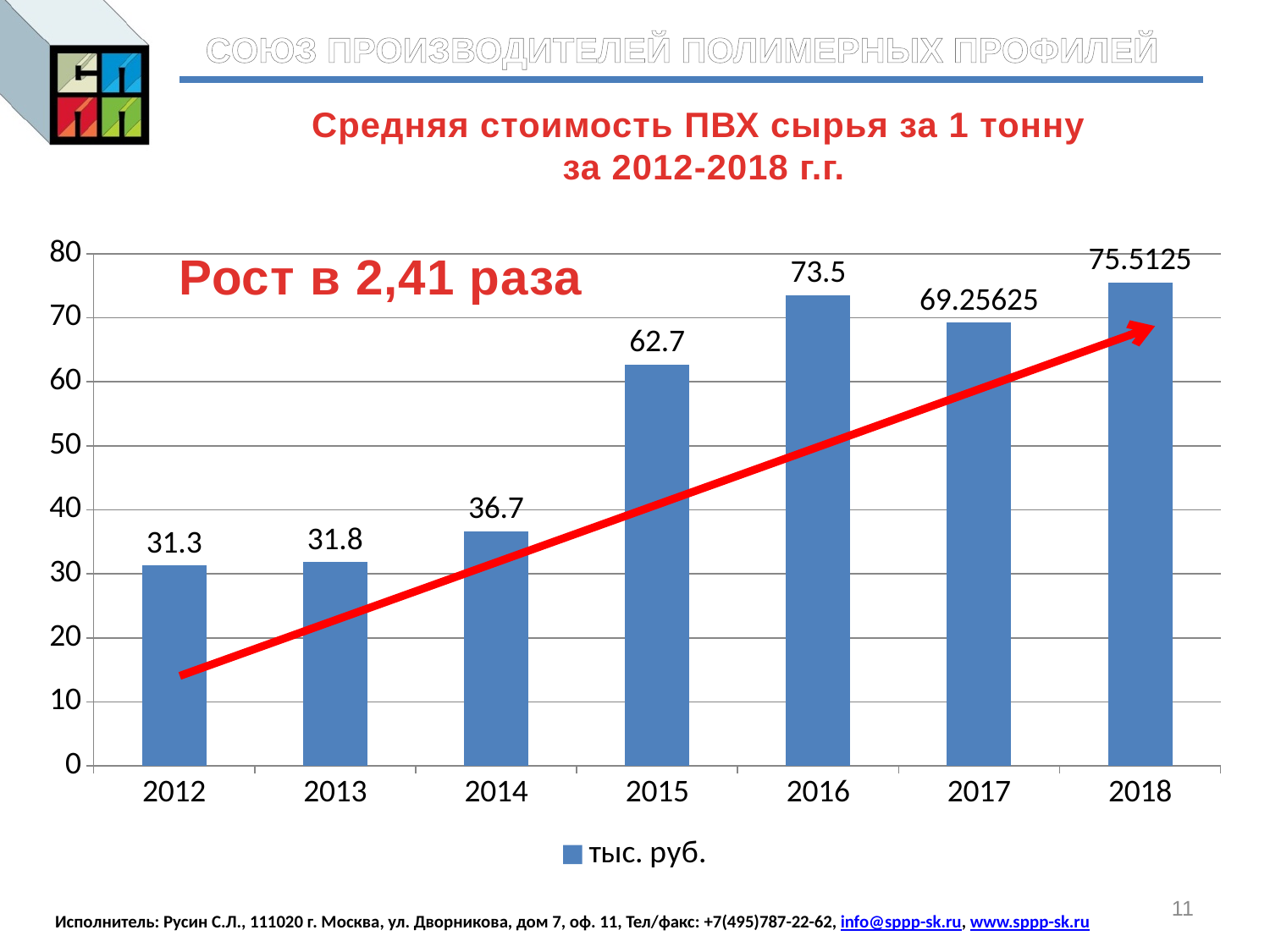
Which is larger, the value for 2016 or the value for 2017? 2016 Which year has the lowest value? 2012 What is the legend entry for the series? тыс. руб. What is the difference between the values for 2016 and 2015? 10.8 What kind of chart is shown on the slide? bar chart What is the value for 2015? 62.7 Which year has the highest value? 2018 How many years are shown on the x axis? 7 What is the value for 2012? 31.3 What is the value for 2017? 69.25625 Is the value for 2014 greater or less than 40? less How many series does the legend list? 1